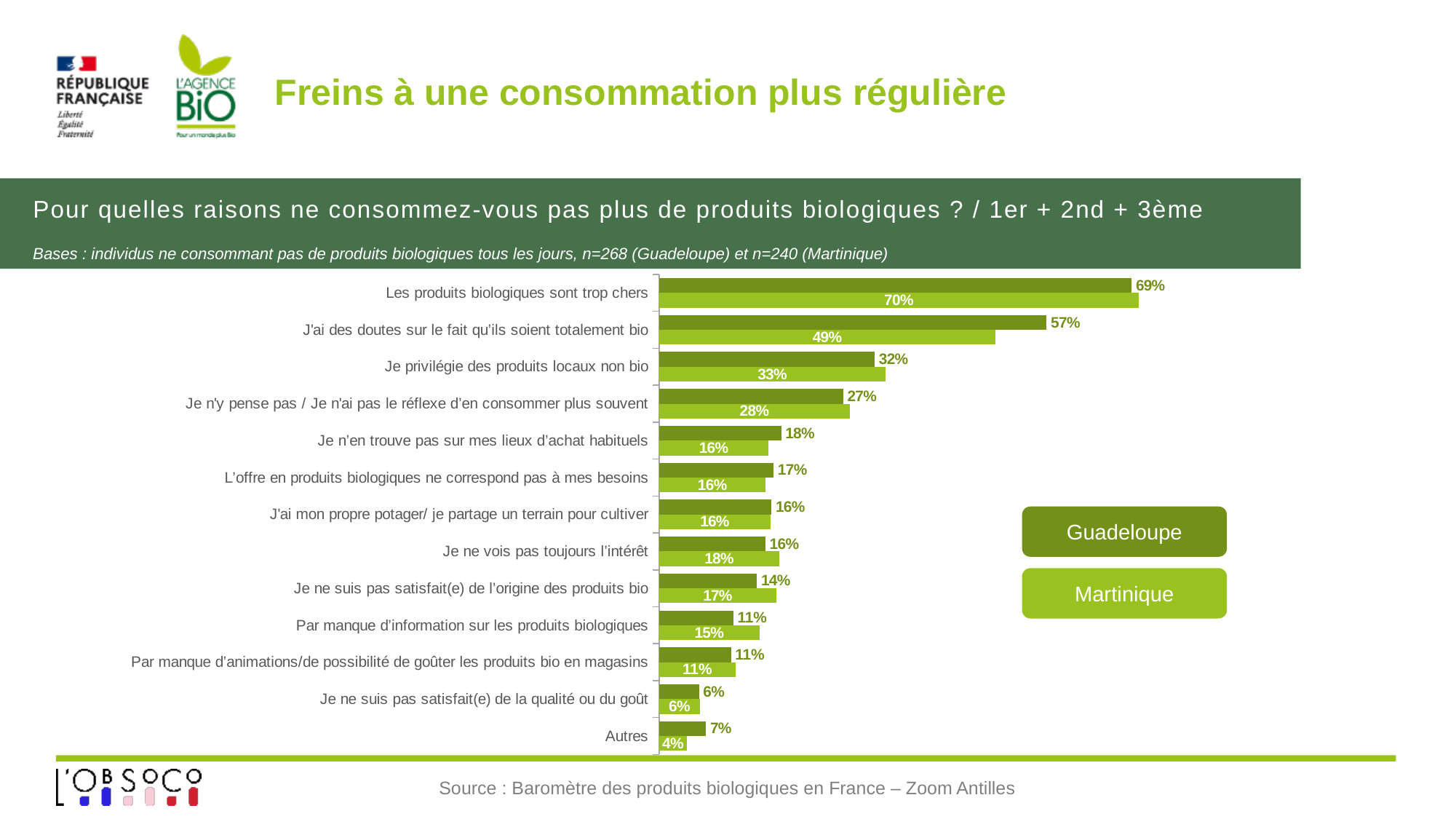
What is the Martinique value for "J'ai des doutes sur le fait qu'ils soient totalement bio"? 49% How many reasons (categories) are plotted in the chart? 13 Which series is shown in the darker green colour? Guadeloupe What type of chart is shown on the slide? Bar chart How many series does the legend list? 2 For "Je ne suis pas satisfait(e) de l'origine des produits bio", which is larger: the Guadeloupe value or the Martinique value? Martinique What is the difference between the Guadeloupe and Martinique values for "J'ai des doutes sur le fait qu'ils soient totalement bio"? 8 percentage points What is the Martinique value for "Par manque d'information sur les produits biologiques"? 15% Which reason has the lowest Martinique value? Autres What is the Guadeloupe value for "Autres"? 7% Which reason has the highest Martinique value? Les produits biologiques sont trop chers What is the Guadeloupe value for "Les produits biologiques sont trop chers"? 69%